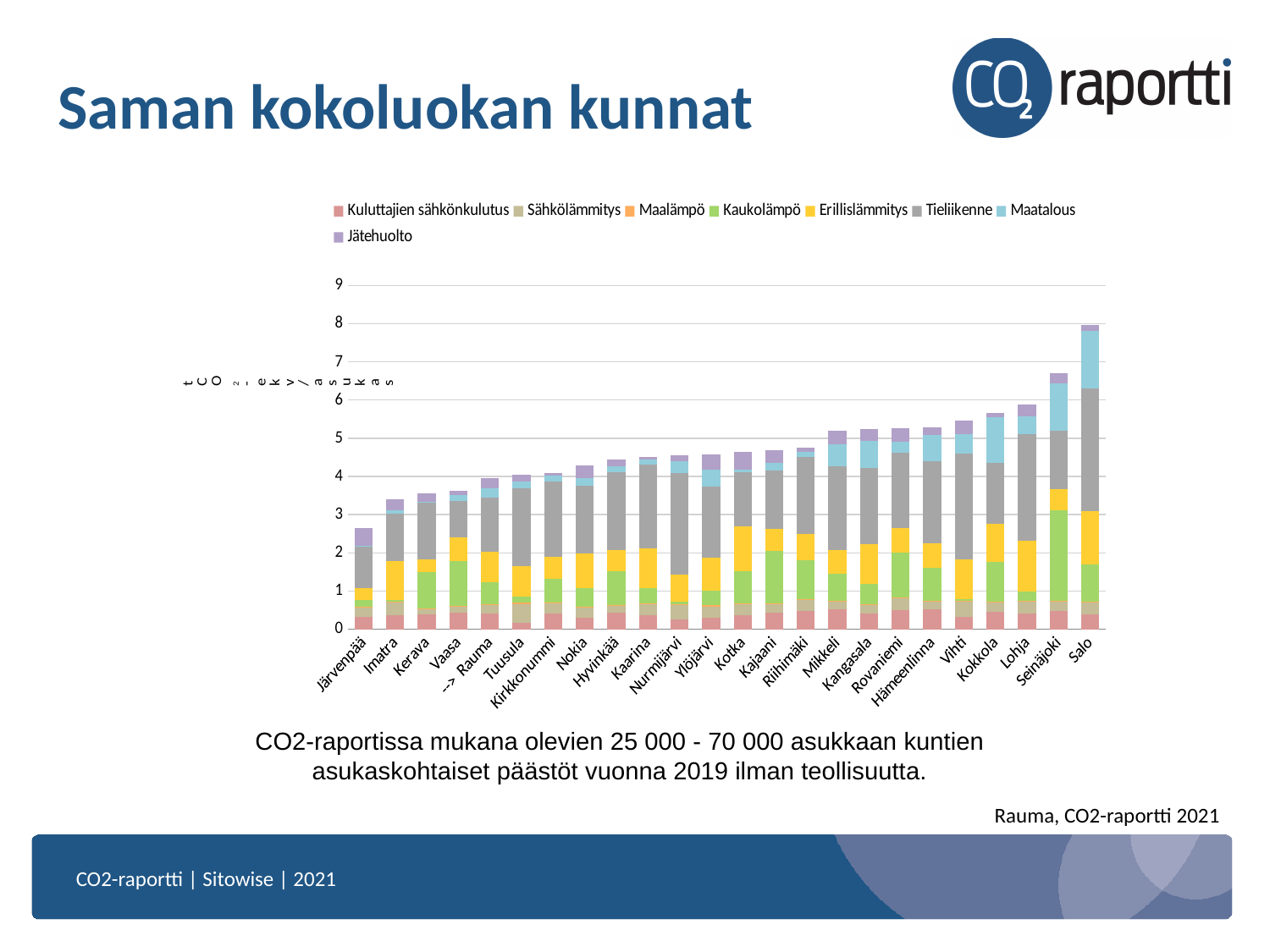
Which legend entry is shown in grey in the chart? Tieliikenne Which municipality has the highest total bar in the chart? Salo Do the total bar heights rise or fall from left to right along the x axis? rise Which has a larger total bar, Salo or Järvenpää? Salo How many series does the chart legend list? 8 Is the total value for Seinäjoki greater or less than 6? greater Is the total value for Imatra greater or less than 4? less Is the total value for Järvenpää greater or less than 3? less Which municipality has the lowest total bar in the chart? Järvenpää How many municipalities are shown on the x axis of the chart? 24 What kind of chart is shown on the slide? stacked bar chart